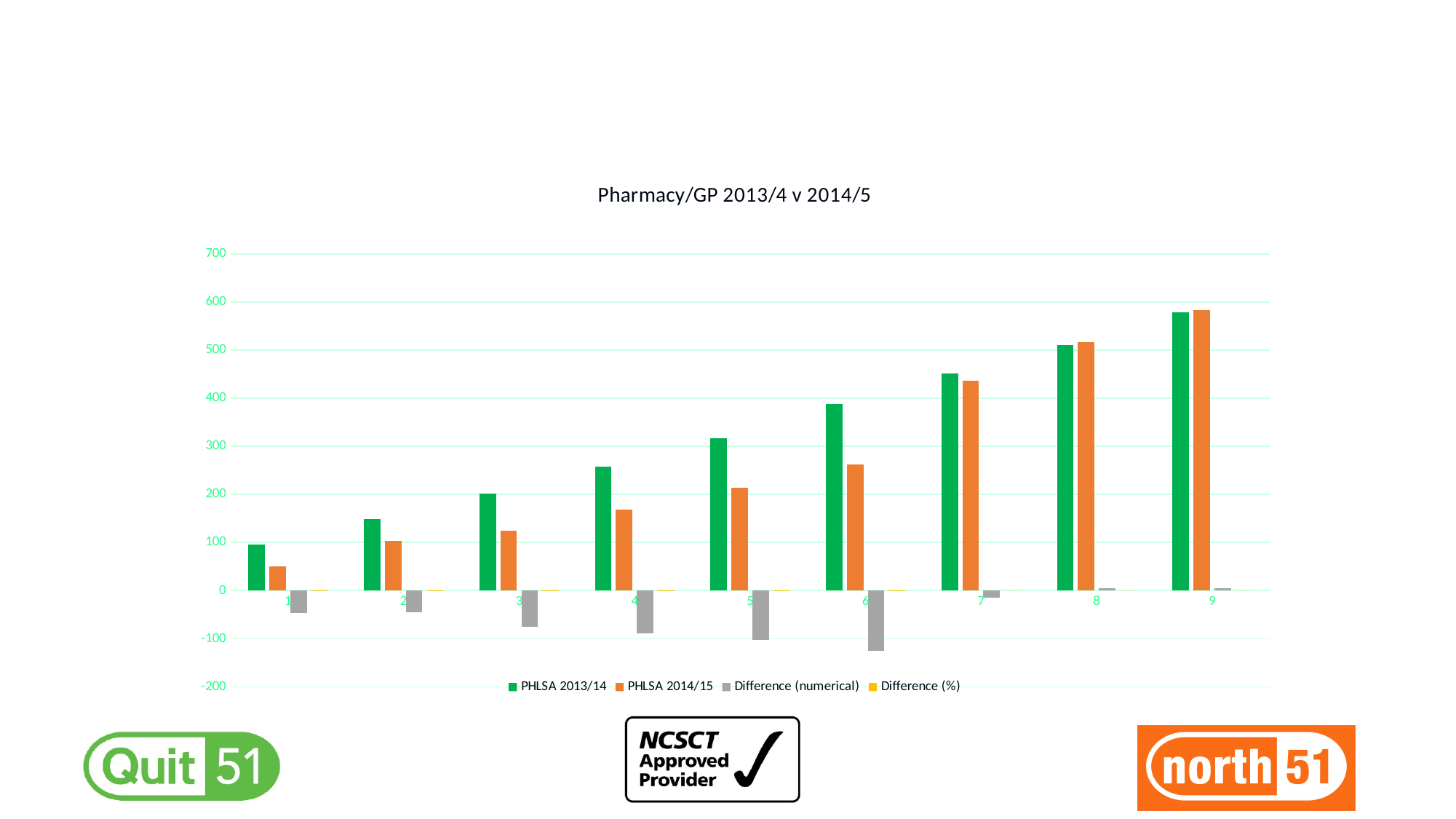
Which category has the lowest Difference (numerical) value? 6 For category 6, which is larger: PHLSA 2013/14 or PHLSA 2014/15? PHLSA 2013/14 How many categories are shown on the x axis? 9 What is the title of the chart? Pharmacy/GP 2013/4 v 2014/5 Is the PHLSA 2013/14 value for category 9 greater or less than 500? greater Which category has the lowest PHLSA 2014/15 value? 1 Which category has the highest PHLSA 2013/14 value? 9 How many series does the legend list? 4 Do the PHLSA 2013/14 values rise or fall from category 1 to category 9? rise Is the Difference (numerical) value for category 6 greater or less than -100? less Is the PHLSA 2014/15 value for category 1 greater or less than 100? less What kind of chart is shown on the slide? bar chart